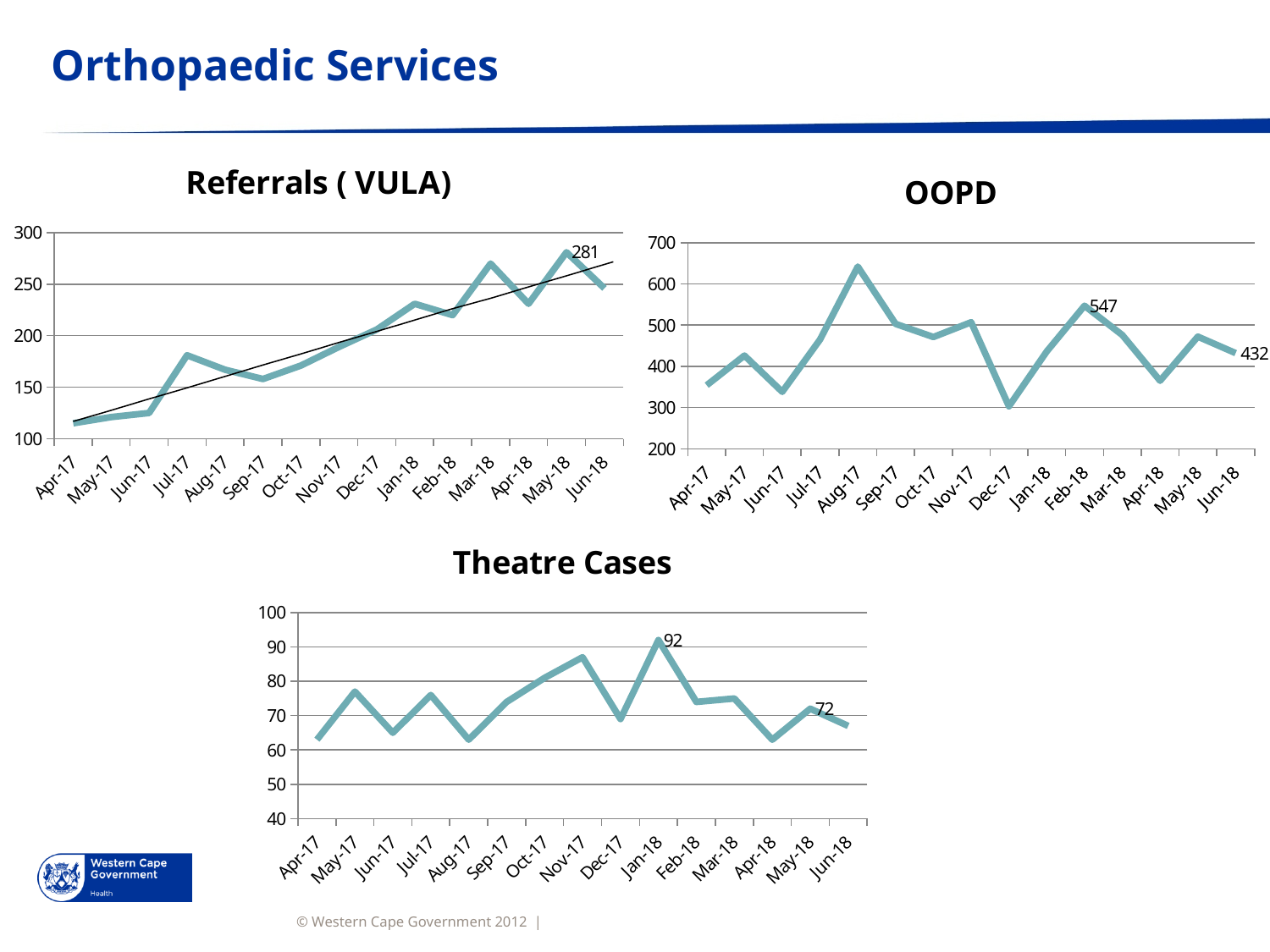
How many months are plotted on the x axis of the Theatre Cases chart? 15 In the OOPD chart, which month has the lowest value? Dec-17 In the OOPD chart, what is the value labelled for Jun-18? 432 In the Theatre Cases chart, how much higher is the Jan-18 value than the May-18 value? 20 In the OOPD chart, which month has the highest value? Aug-17 In the Referrals ( VULA) chart, what is the value labelled for May-18? 281 Overall, do the values in the Referrals ( VULA) chart rise or fall from Apr-17 to Jun-18? rise In the OOPD chart, what is the difference between the Feb-18 value and the Jun-18 value? 115 In the Theatre Cases chart, which month has the highest value? Jan-18 In the OOPD chart, what is the value labelled for Feb-18? 547 In the Referrals ( VULA) chart, is the value for Apr-17 greater or less than 150? less In the Theatre Cases chart, what is the value labelled for Jan-18? 92